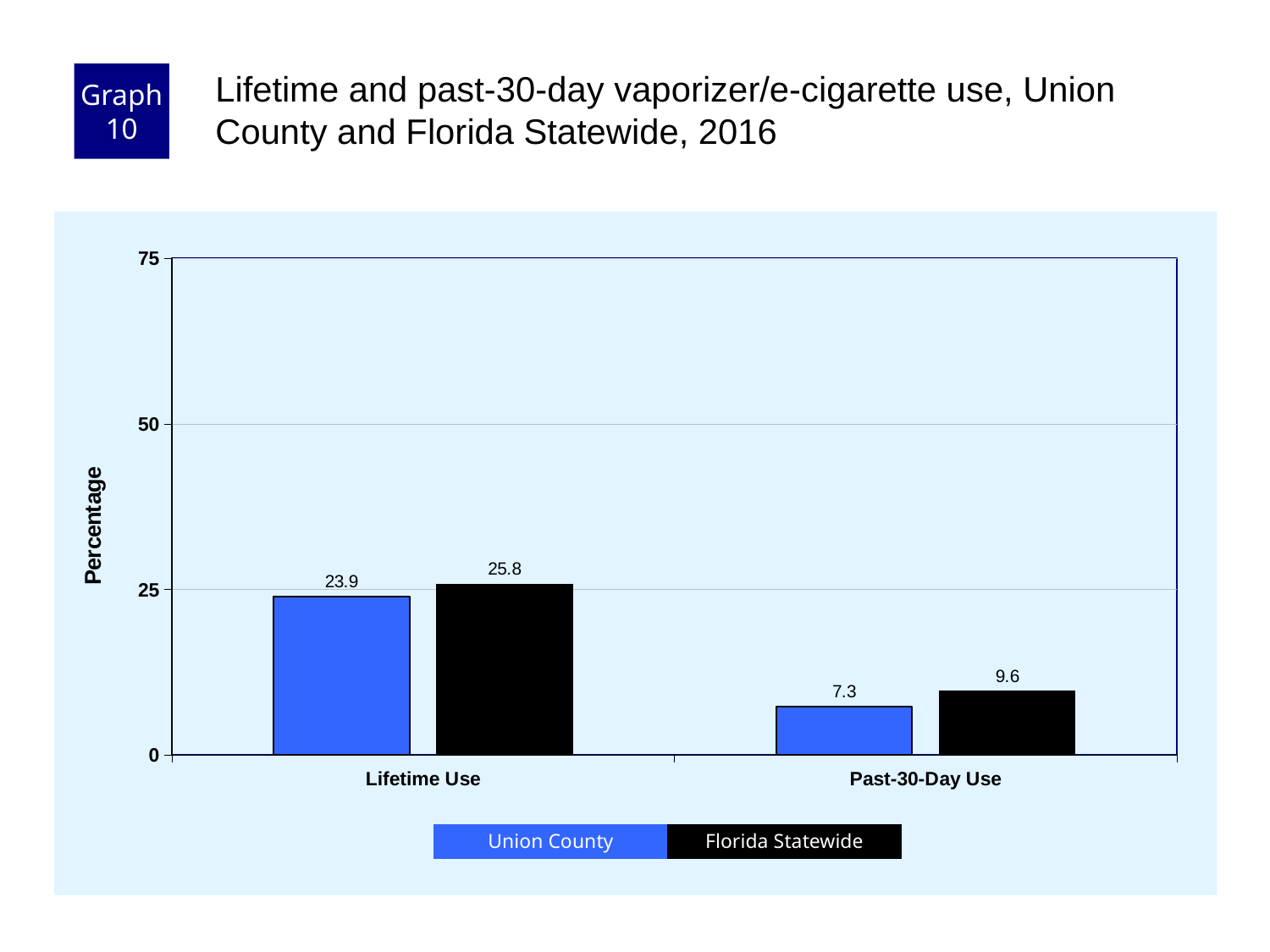
What is the Union County value for Lifetime Use? 23.9 For Past-30-Day Use, which is larger: Union County or Florida Statewide? Florida Statewide How many series does the legend list? 2 What is the Florida Statewide value for Lifetime Use? 25.8 What is the difference between the Florida Statewide and Union County values for Lifetime Use? 1.9 What is the difference between the Florida Statewide and Union County values for Past-30-Day Use? 2.3 What is the Union County value for Past-30-Day Use? 7.3 Which bar has the highest value on the chart? Florida Statewide, Lifetime Use What kind of chart is shown on the slide? Bar chart Which bar has the lowest value on the chart? Union County, Past-30-Day Use What is the Florida Statewide value for Past-30-Day Use? 9.6 Is the Florida Statewide value for Lifetime Use greater or less than 25? greater